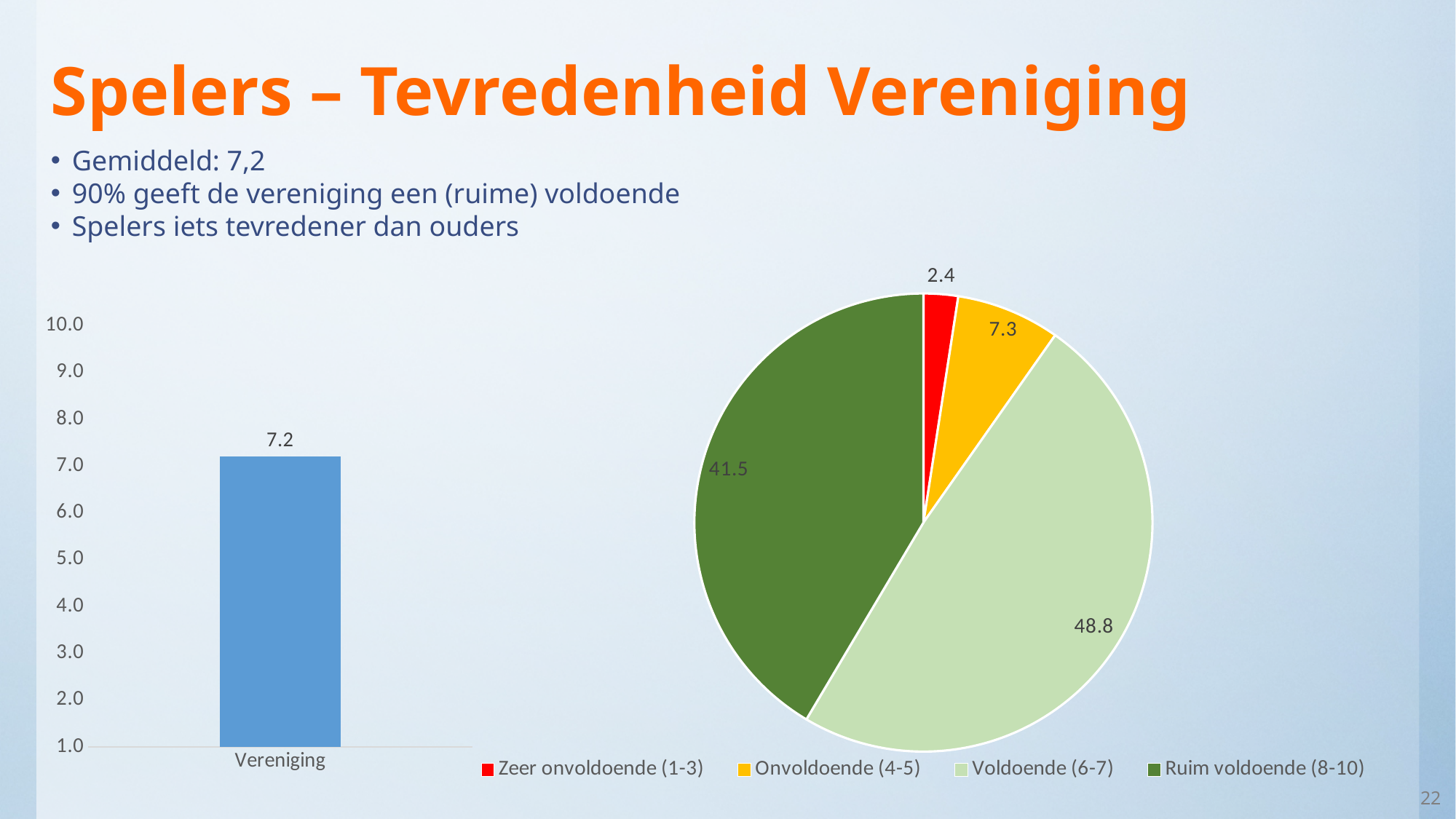
What kind of chart is the chart on the right of the slide? pie chart In the bar chart on the left, how many categories are shown? 1 In the pie chart on the right, which category has the largest slice? Voldoende (6-7) In the pie chart on the right, what is the value for Ruim voldoende (8-10)? 41.5 In the bar chart on the left, what is the value for Vereniging? 7.2 In the pie chart on the right, what is the difference between Voldoende (6-7) and Ruim voldoende (8-10)? 7.3 In the pie chart on the right, what is the value for Voldoende (6-7)? 48.8 In the pie chart on the right, which category has the smallest slice? Zeer onvoldoende (1-3) What kind of chart is the chart on the left of the slide? bar chart In the bar chart on the left, is the value for Vereniging greater or less than 7.0? greater In the pie chart on the right, what is the value for Zeer onvoldoende (1-3)? 2.4 In the pie chart on the right, how many categories does the legend list? 4